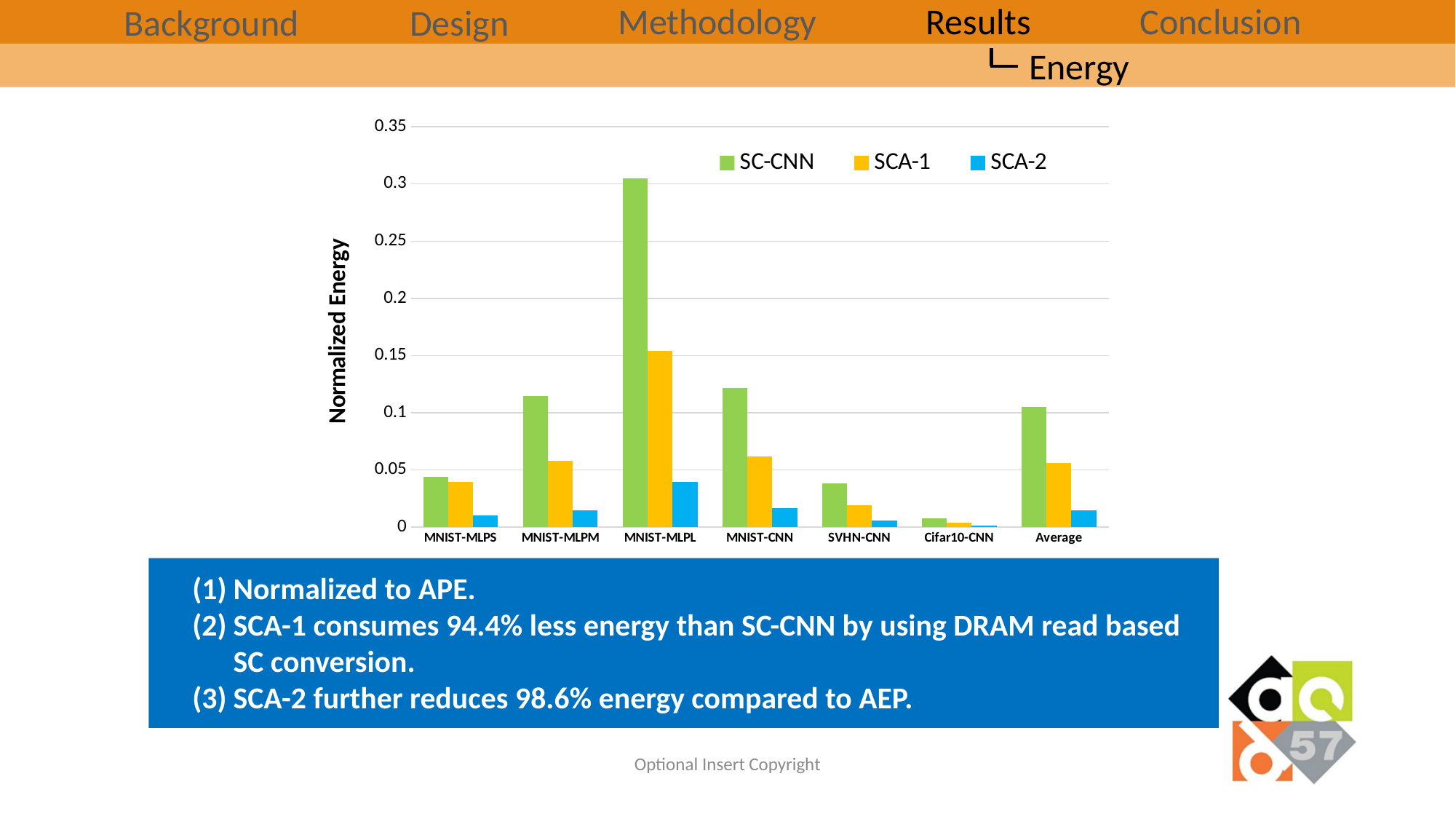
What kind of chart is shown on the slide? bar chart For the SCA-1 series, which category has the highest normalized energy? MNIST-MLPL How many series does the chart's legend list? 3 What is the label on the chart's y axis? Normalized Energy For MNIST-MLPM, which series has the larger normalized energy, SC-CNN or SCA-1? SC-CNN For the SC-CNN series, which category has the lowest normalized energy? Cifar10-CNN Is the SC-CNN value for Average greater or less than 0.15? less Is the SC-CNN value for MNIST-MLPL greater or less than 0.25? greater Is the SCA-1 value for MNIST-MLPL greater or less than 0.1? greater For the SC-CNN series, which category has the highest normalized energy? MNIST-MLPL For the SCA-2 series, which is larger, the value for MNIST-MLPL or the value for MNIST-CNN? MNIST-MLPL How many categories are shown along the x axis of the chart? 7